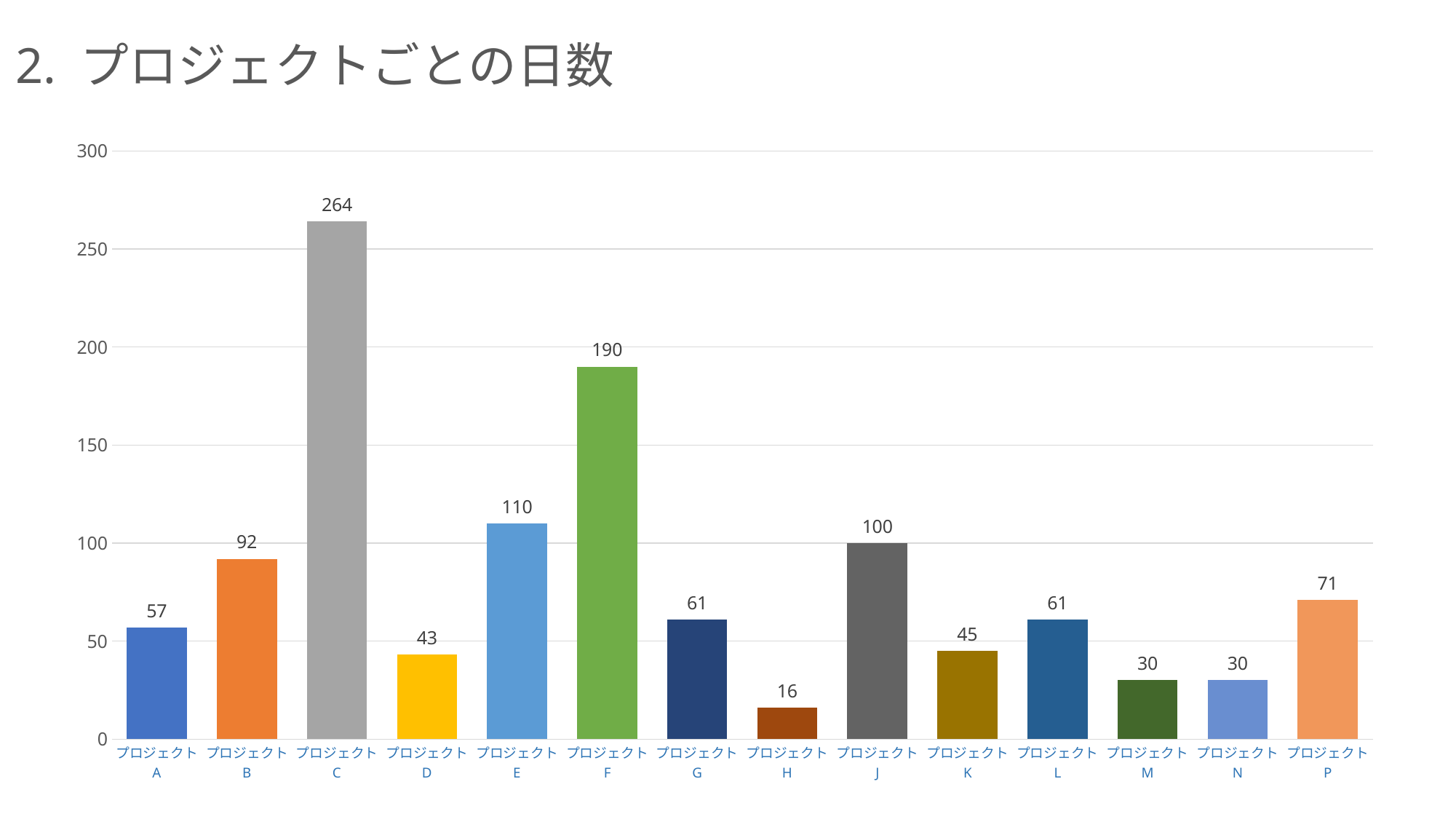
What is the difference between the values for プロジェクトC and プロジェクトF? 74 Which project has the highest value? プロジェクトC What is the value for プロジェクトC? 264 What kind of chart is shown on the slide? bar chart Which project has the lowest value? プロジェクトH How many projects are shown on the chart? 14 What is the value for プロジェクトJ? 100 What is the difference between the values for プロジェクトB and プロジェクトA? 35 Is the value for プロジェクトF greater or less than 150? greater What is the title of the slide? 2. プロジェクトごとの日数 Which is larger, the value for プロジェクトE or the value for プロジェクトJ? プロジェクトE What is the value for プロジェクトH? 16